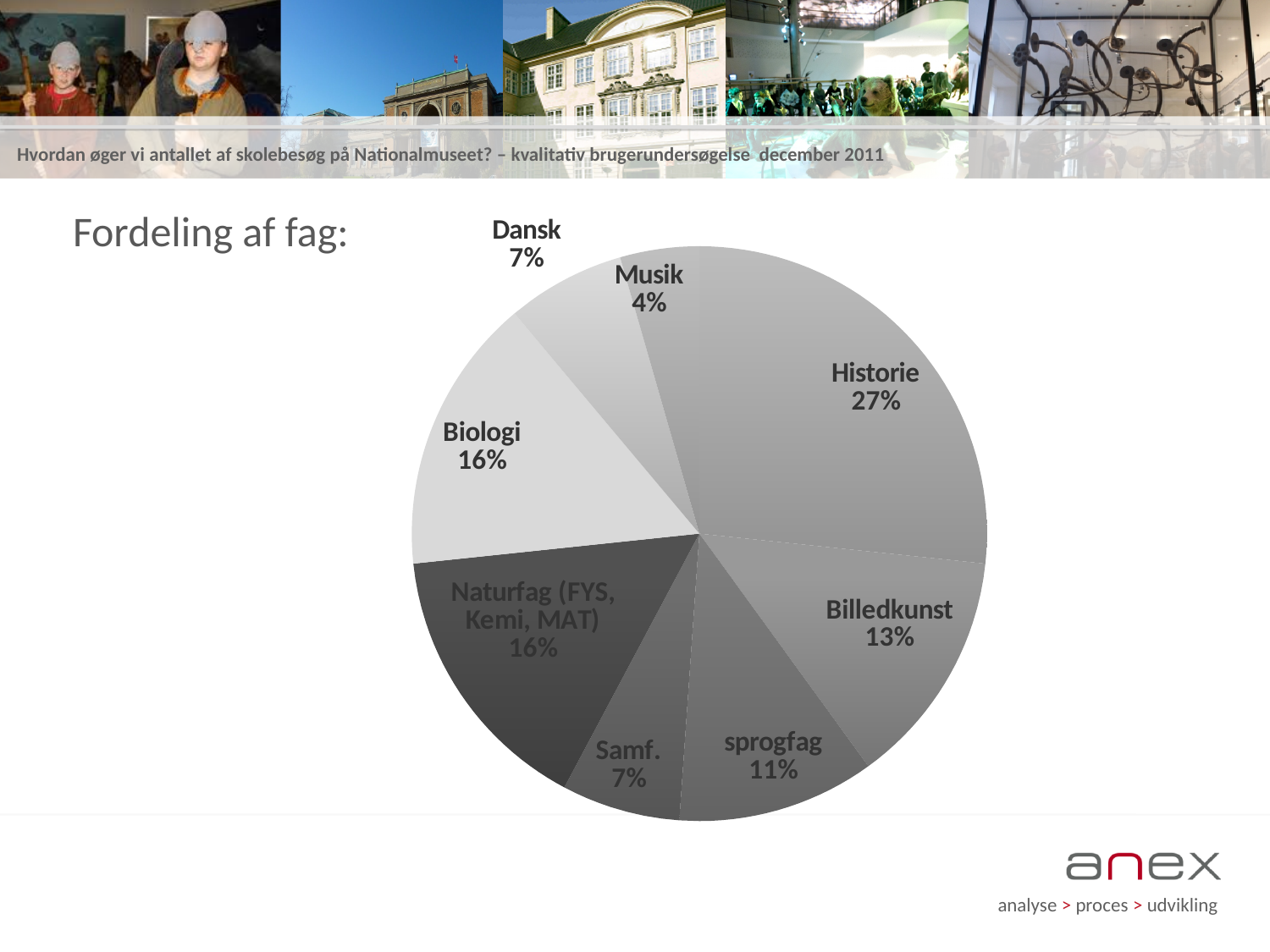
What is the value shown for Billedkunst? 13% What is the heading shown next to the pie chart? Fordeling af fag: What share of the pie does Historie have? 27% What is the value shown for Naturfag (FYS, Kemi, MAT)? 16% What is the value shown for sprogfag? 11% What is the difference between the shares of Historie and Billedkunst? 14% What is the value shown for Musik? 4% How many slices does the pie chart have? 8 Which has a larger share, Biologi or sprogfag? Biologi Which subject has the smallest slice of the pie? Musik Which subject has the largest slice of the pie? Historie What type of chart is shown on the slide? pie chart